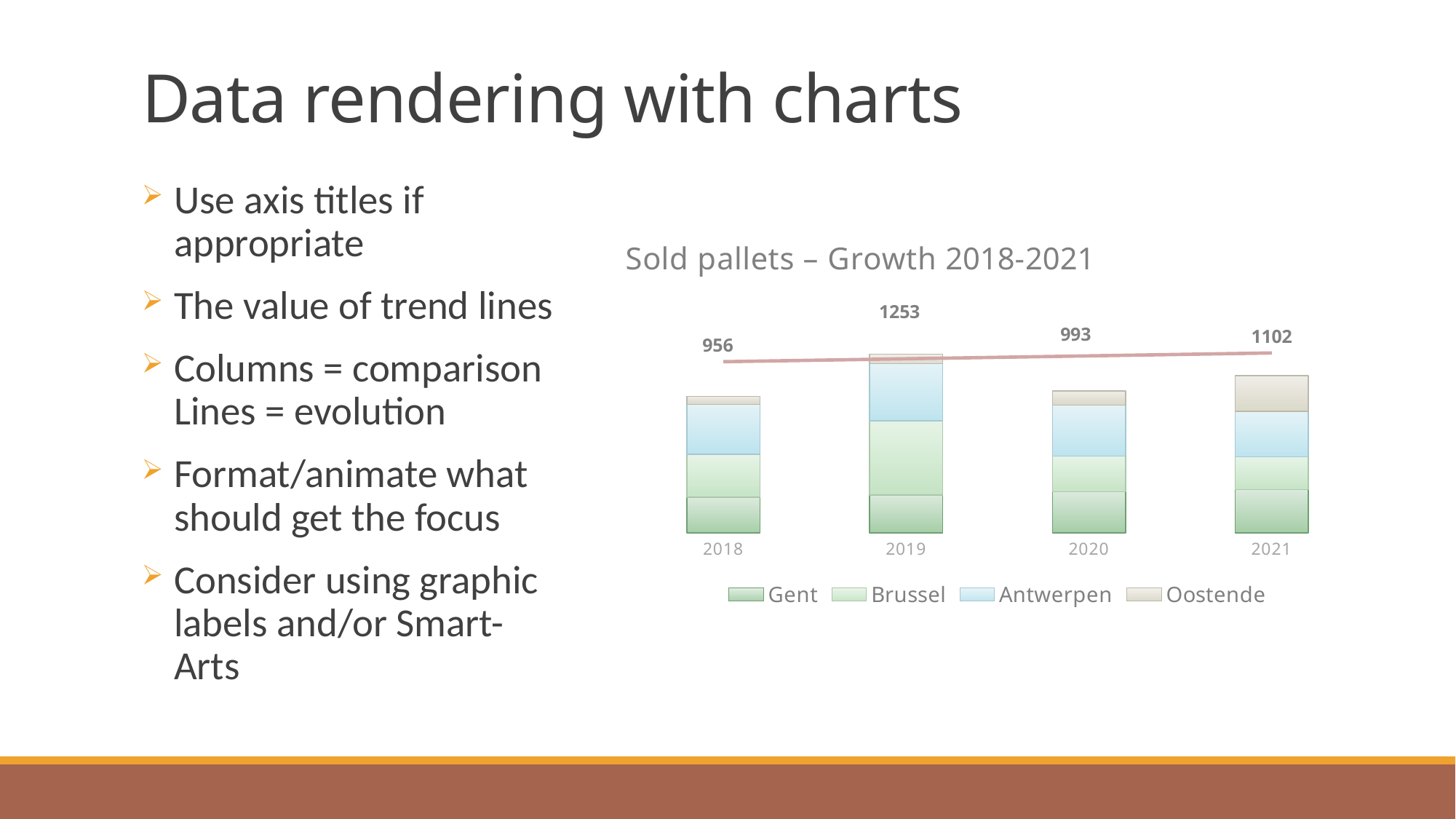
Which year has the lowest total of sold pallets? 2018 How many series does the legend list? 4 What is the difference between the 2021 total and the 2020 total? 109 Which total is larger, 2020 or 2021? 2021 What is the title of the chart? Sold pallets – Growth 2018-2021 What is the total of the stacked bar for 2020? 993 How many years are shown on the x axis of the chart? 4 Which year has the highest total of sold pallets? 2019 What is the difference between the 2019 total and the 2018 total? 297 What is the total of the stacked bar for 2019 in the 'Sold pallets – Growth 2018-2021' chart? 1253 What is the total of the stacked bar for 2021? 1102